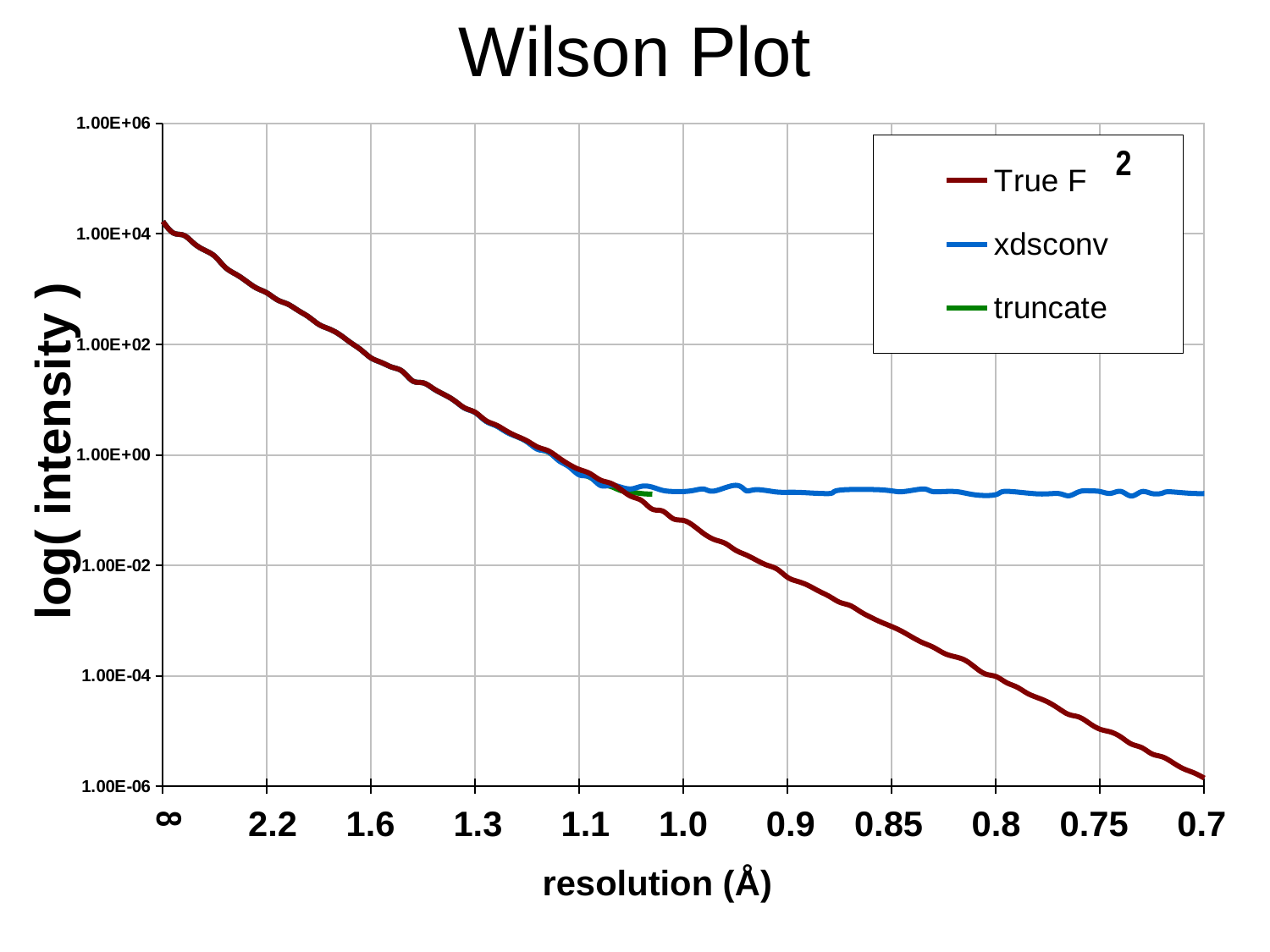
What kind of chart is shown on the slide? line chart Is the value of the xdsconv series at 0.7 Å greater or less than 1.00E-02? greater Is the value of the True F² series at 2.2 Å greater or less than 1.00E+02? greater How many series does the legend list? 3 Is the value of the xdsconv series at 0.7 Å greater or less than 1.00E+00? less What is the title of the chart? Wilson Plot At a resolution of 0.7 Å, which series has the higher value, xdsconv or True F²? xdsconv How many tick labels are shown on the x axis? 11 What is the label of the x axis? resolution (Å) Does the True F² series rise or fall as resolution goes from ∞ to 0.7 along the x axis? fall